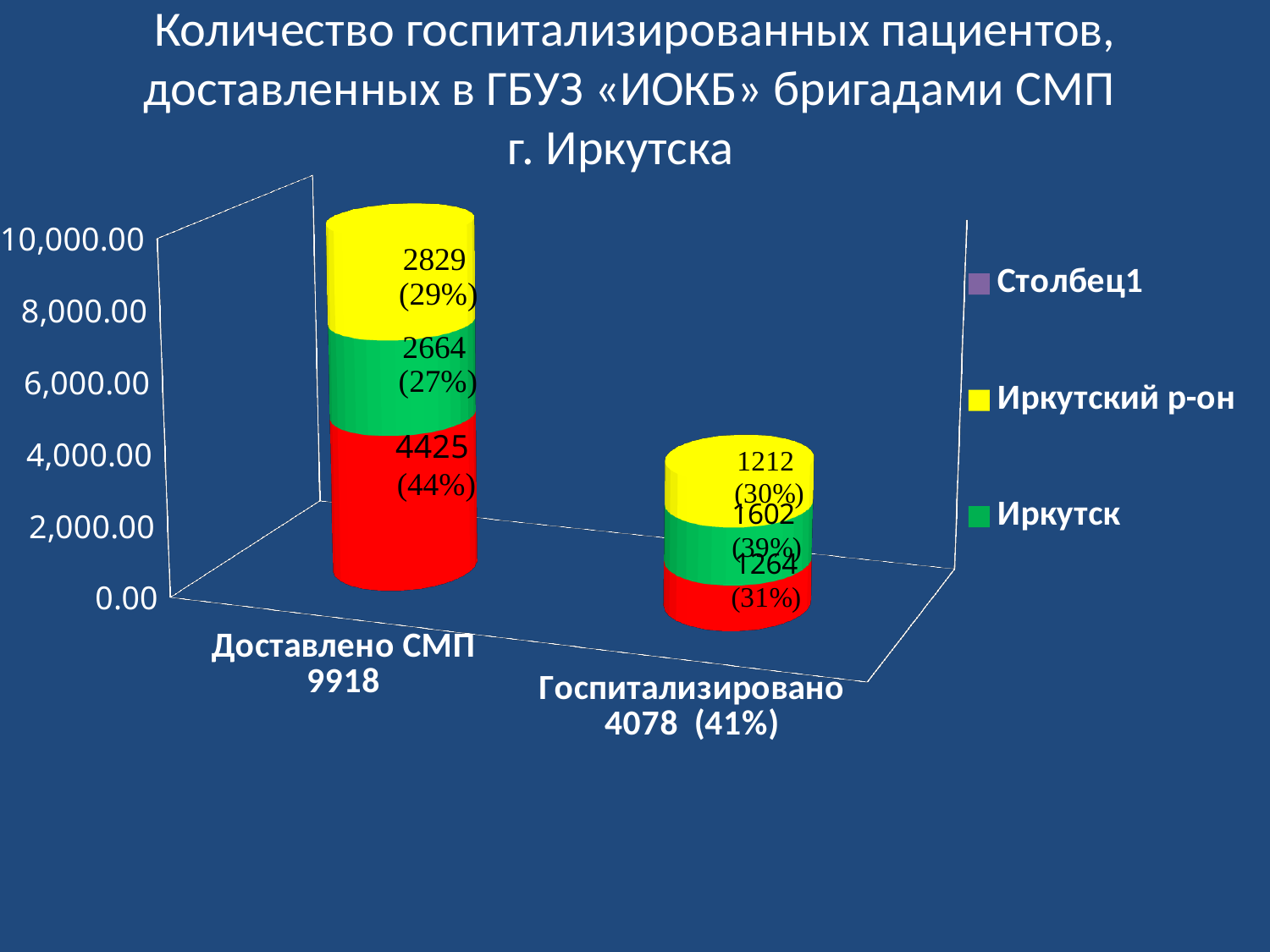
Which bar is taller overall, Доставлено СМП or Госпитализировано? Доставлено СМП What is the value of the yellow (Иркутский р-он) segment in the Госпитализировано bar? 1212 What percentage is shown for the red segment in the Госпитализировано bar? 31% What is the value of the green (Иркутск) segment in the Госпитализировано bar? 1602 What is the value of the green (Иркутск) segment in the Доставлено СМП bar? 2664 What kind of chart is shown on the slide? Stacked bar chart How many entries does the legend list? 3 What is the total of the Доставлено СМП stacked bar? 9918 What is the value of the red segment in the Доставлено СМП bar? 4425 What is the difference between the red segment values of the Доставлено СМП bar (4425) and the Госпитализировано bar (1264)? 3161 What is the total of the Госпитализировано stacked bar? 4078 What is the value of the yellow (Иркутский р-он) segment in the Доставлено СМП bar? 2829